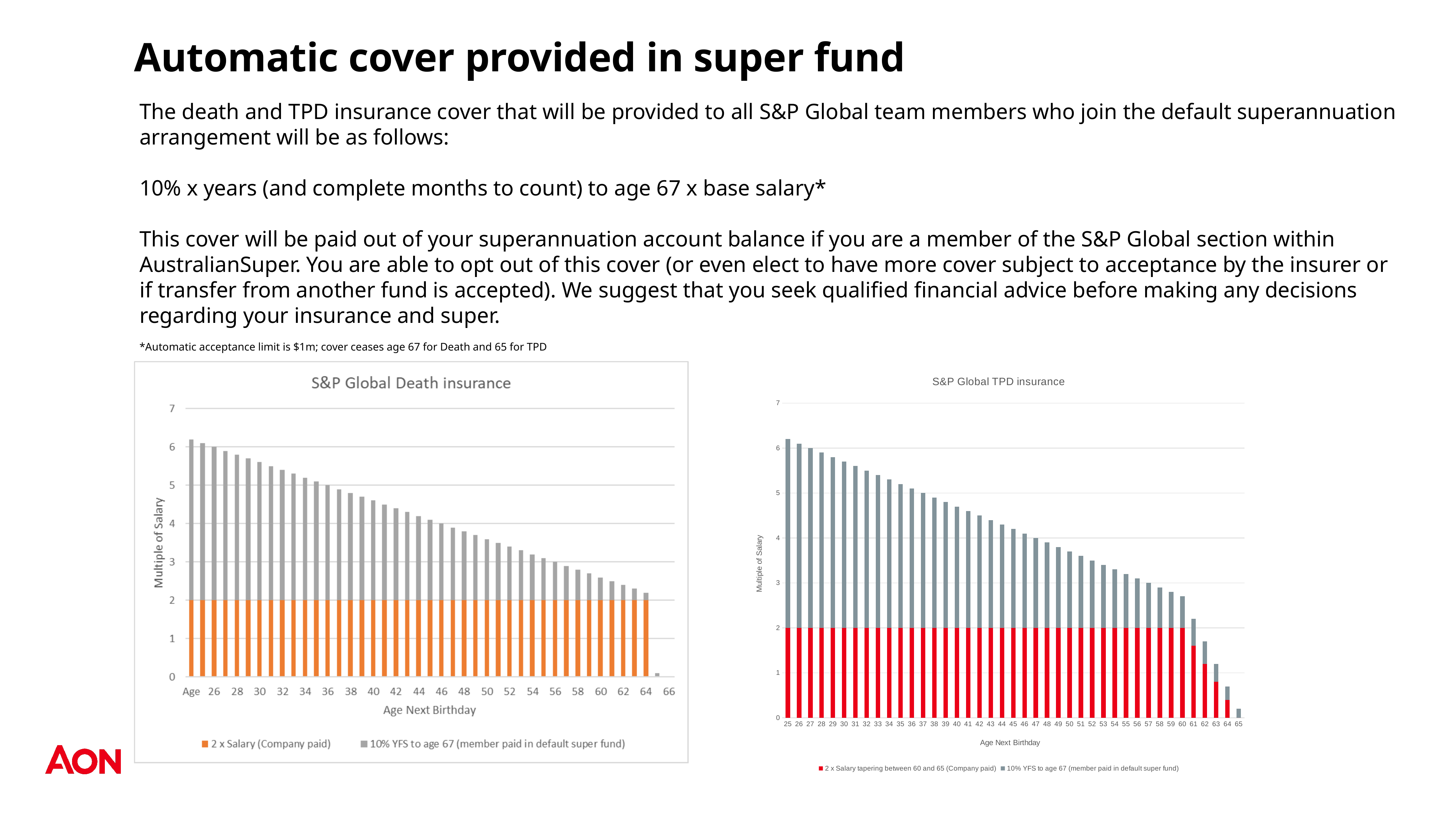
In the S&P Global TPD insurance chart, is the total bar for age next birthday 25 greater or less than 6? greater In the S&P Global TPD insurance chart, which age next birthday has the lowest total bar? 65 What is the y-axis title of the S&P Global TPD insurance chart? Multiple of Salary In the S&P Global TPD insurance chart, what is the value of the 2 x Salary tapering series at age next birthday 30? 2 In the S&P Global Death insurance chart, which total bar is larger: age next birthday 30 or age next birthday 60? 30 In the S&P Global TPD insurance chart, is the total bar for age next birthday 60 greater or less than 3? less What kind of chart is the S&P Global Death insurance chart? Stacked bar chart In the S&P Global TPD insurance chart, which age next birthday has the highest total bar? 25 In the S&P Global Death insurance chart, what is the value of the 2 x Salary (Company paid) series at age next birthday 40? 2 In the S&P Global Death insurance chart, is the total bar for age next birthday 50 greater or less than 4? less How many series does the legend of the S&P Global TPD insurance chart list? 2 In the S&P Global Death insurance chart, do the total bar heights rise or fall as age next birthday increases? Fall